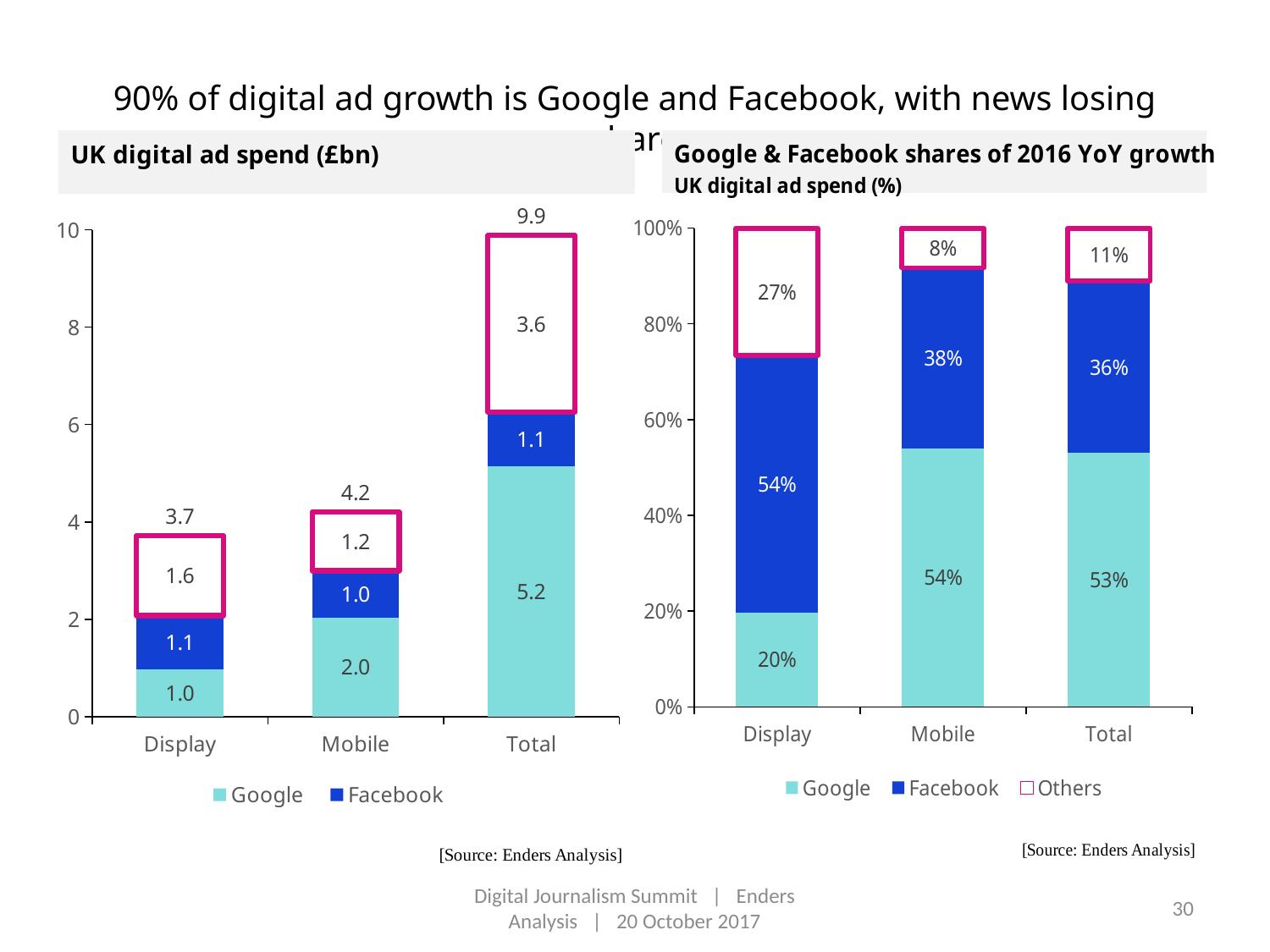
In the 'Google & Facebook shares of 2016 YoY growth' chart, what is the Facebook share for Display? 54% In the 'UK digital ad spend (£bn)' chart, how many series does the legend list? 2 In the 'Google & Facebook shares of 2016 YoY growth' chart, which category has the highest Others share? Display In the 'Google & Facebook shares of 2016 YoY growth' chart, how many series does the legend list? 3 What type of chart is the 'UK digital ad spend (£bn)' chart? Stacked bar chart In the 'UK digital ad spend (£bn)' chart, what is the Google value for Mobile? 2.0 In the 'UK digital ad spend (£bn)' chart, which category has the lowest total? Display In the 'UK digital ad spend (£bn)' chart, what is the Facebook value for Display? 1.1 In the 'Google & Facebook shares of 2016 YoY growth' chart, is the Google share larger for Display or for Mobile? Mobile In the 'UK digital ad spend (£bn)' chart, what is the total value labelled above the Total bar? 9.9 In the 'UK digital ad spend (£bn)' chart, what is the difference between the Google values for Total and Mobile? 3.2 In the 'Google & Facebook shares of 2016 YoY growth' chart, what is the Others share for Mobile? 8%